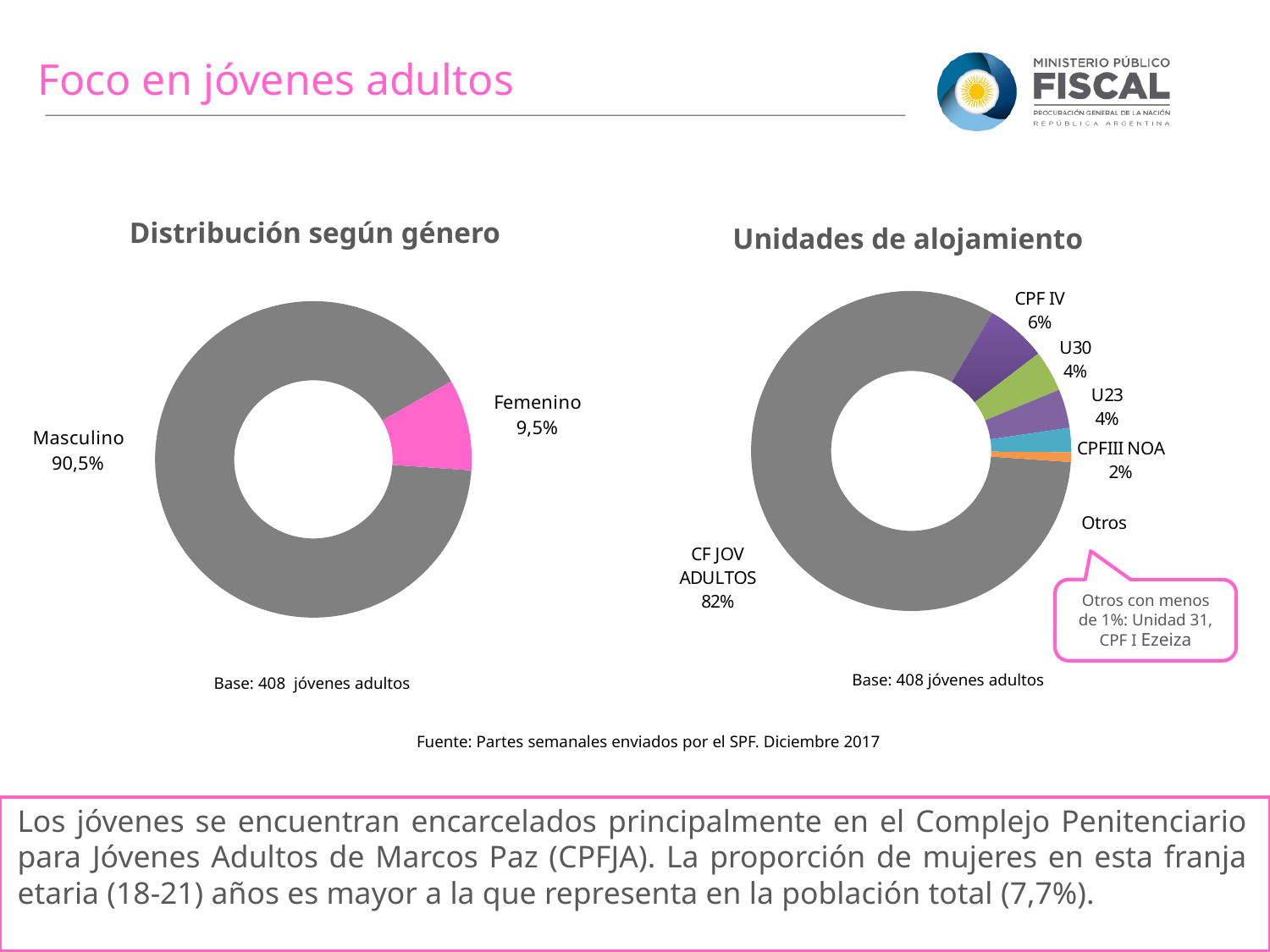
In the 'Distribución según género' chart, what is the difference in percentage points between Masculino and Femenino? 81 percentage points How many categories are shown in the 'Unidades de alojamiento' chart? 6 What type of chart is the 'Distribución según género' chart? Donut (pie) chart In the 'Unidades de alojamiento' chart, what percentage is CPFIII NOA? 2% In the 'Distribución según género' chart, what percentage is Femenino? 9,5% In the 'Distribución según género' chart, what percentage is Masculino? 90,5% In the 'Unidades de alojamiento' chart, what percentage is CF JOV ADULTOS? 82% In the 'Unidades de alojamiento' chart, which unit has the largest share? CF JOV ADULTOS In the 'Unidades de alojamiento' chart, which is larger, CPF IV or U30? CPF IV In the 'Unidades de alojamiento' chart, what is the difference in percentage points between CF JOV ADULTOS and CPF IV? 76 percentage points In the 'Unidades de alojamiento' chart, what percentage is CPF IV? 6% In the 'Distribución según género' chart, which category has the larger share? Masculino